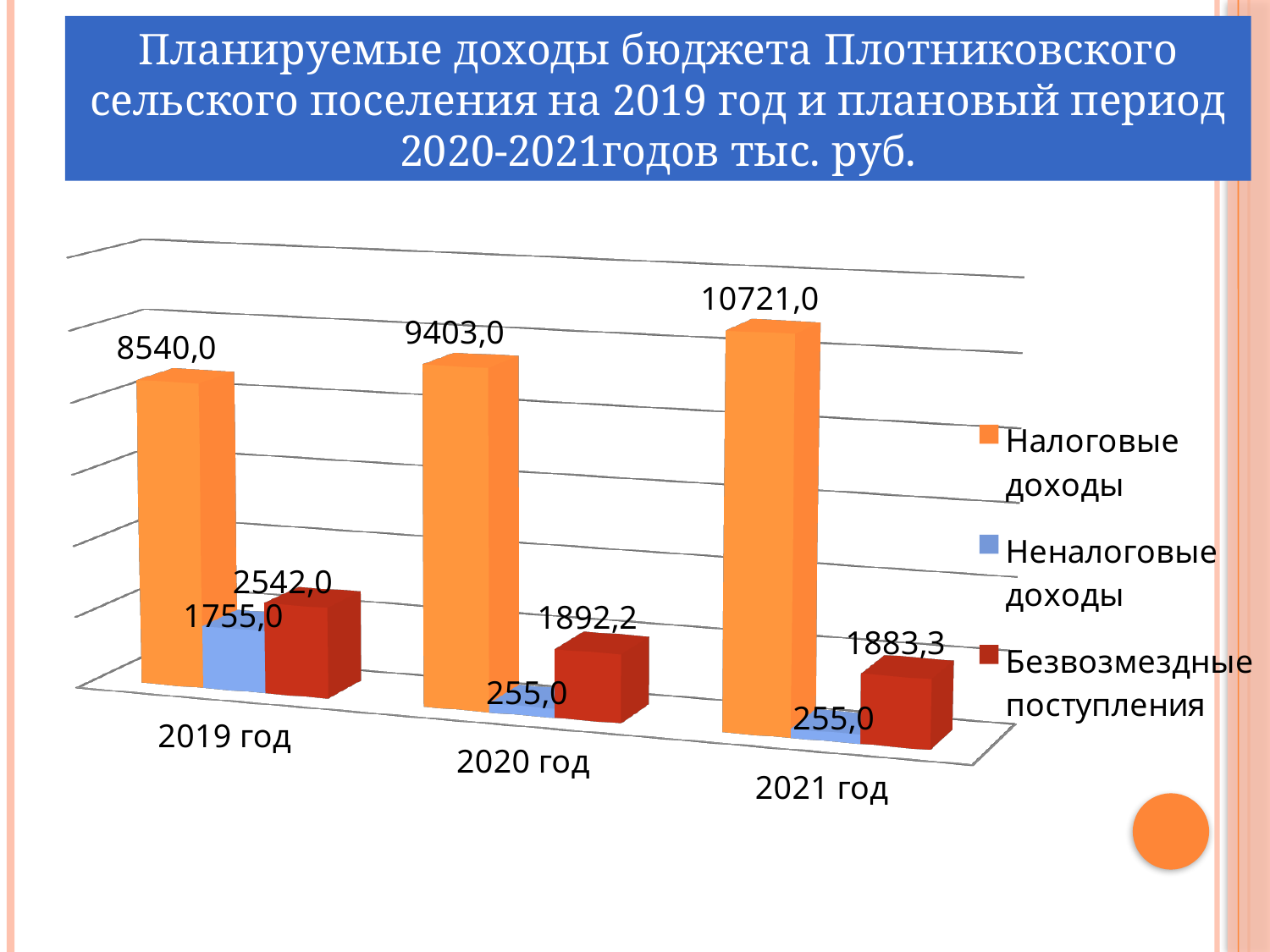
What is the value of Налоговые доходы for 2019 год? 8540,0 Do the values of Налоговые доходы rise or fall from 2019 год to 2021 год? rise Which is larger for 2019 год: Неналоговые доходы or Безвозмездные поступления? Безвозмездные поступления What is the value of Безвозмездные поступления for 2020 год? 1892,2 What is the value of Неналоговые доходы for 2021 год? 255,0 In which year is Налоговые доходы the highest? 2021 год In which year is Неналоговые доходы the highest? 2019 год How many series does the legend list? 3 What is the difference between Налоговые доходы in 2021 год and in 2019 год? 2181,0 What is the difference between Неналоговые доходы in 2019 год and in 2020 год? 1500,0 What is the value of Безвозмездные поступления for 2021 год? 1883,3 In which year is Безвозмездные поступления the lowest? 2021 год